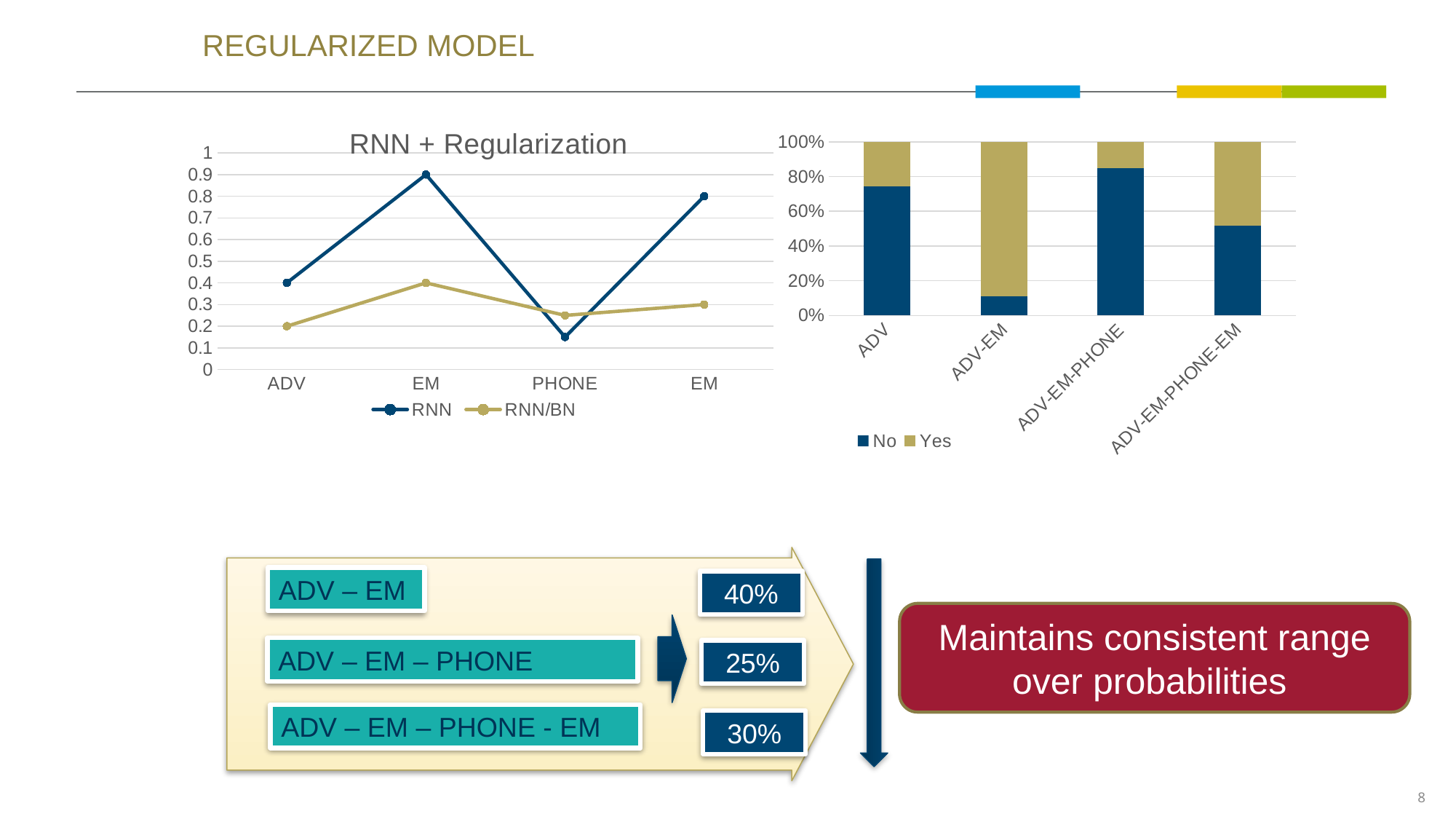
In the chart on the right, is the 'No' value for ADV-EM-PHONE greater or less than 80%? greater In the 'RNN + Regularization' chart, how many series does the legend list? 2 In the chart on the right, is the 'No' value for ADV-EM greater or less than 20%? less What kind of chart is the chart on the right of the slide with the No/Yes legend? bar chart In the chart on the right, how many categories are shown on the x axis? 4 What kind of chart is the 'RNN + Regularization' chart on the left? line chart In the 'RNN + Regularization' chart, what is the RNN value for ADV? 0.4 In the 'RNN + Regularization' chart, what is the difference between the RNN and RNN/BN values for ADV? 0.2 In the chart on the right, what are the two legend entries? No, Yes In the 'RNN + Regularization' chart, at which category is the RNN series lowest? PHONE In the 'RNN + Regularization' chart, which series has the larger value at ADV, RNN or RNN/BN? RNN In the 'RNN + Regularization' chart, what is the RNN/BN value for ADV? 0.2